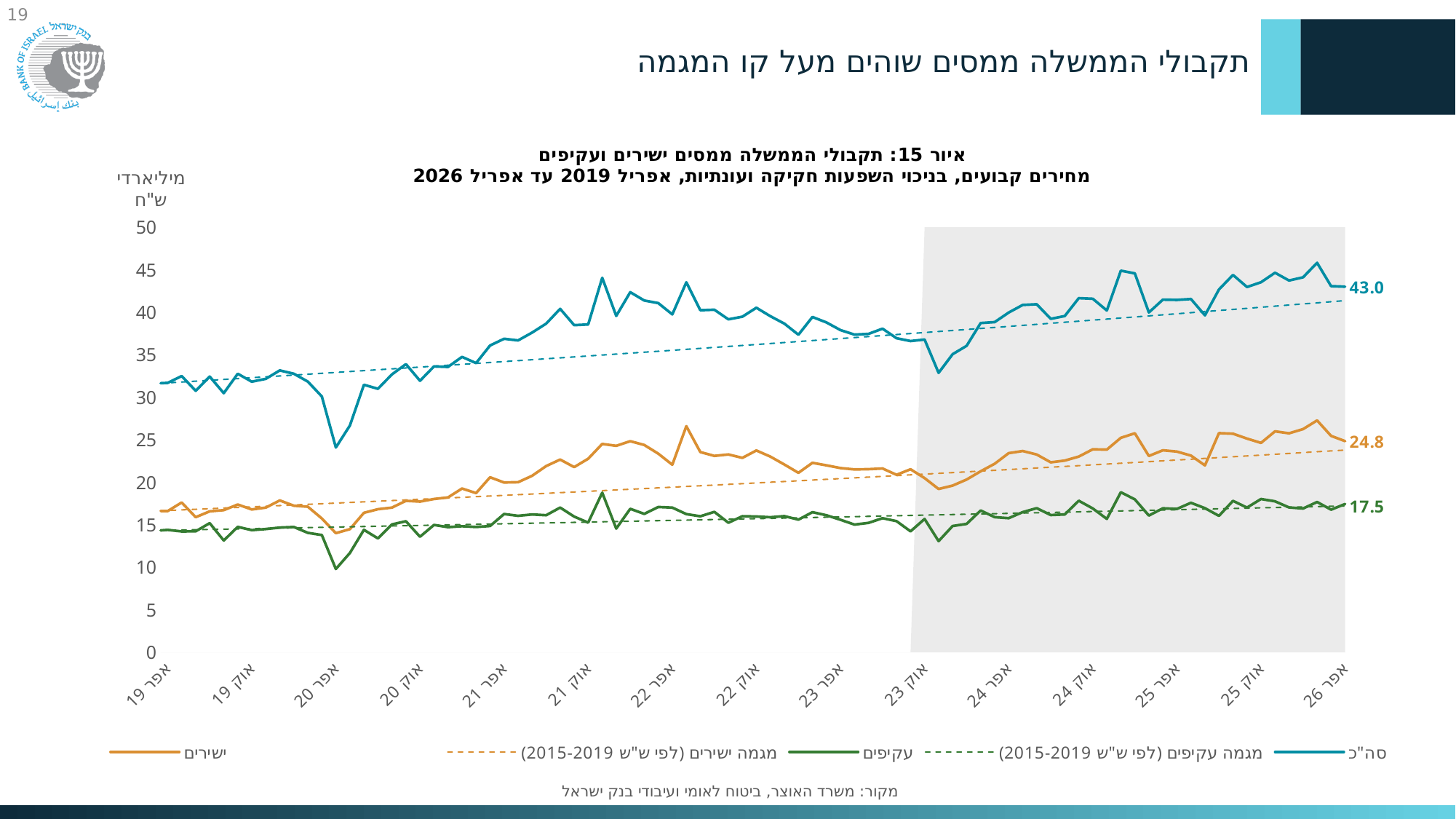
What is the difference between the final labelled values of ישירים and עקיפים? 7.3 What is the value labelled at the end of the סה"כ line (אפר 26)? 43.0 At אפר 26, which is larger: ישירים or עקיפים? ישירים Is the value of the סה"כ line at its dip around אפר 20 greater or less than 30? less What kind of chart is shown on the slide? line chart Does the סה"כ line rise or fall overall from אפר 19 to אפר 26? rises What unit is shown on the y axis? מיליארדי ש"ח How many series does the legend list? 5 What is the value labelled at the end of the ישירים line (אפר 26)? 24.8 What is the difference between the final labelled values of סה"כ and ישירים? 18.2 Which series has the highest value at אפר 26? סה"כ What is the value labelled at the end of the עקיפים line (אפר 26)? 17.5